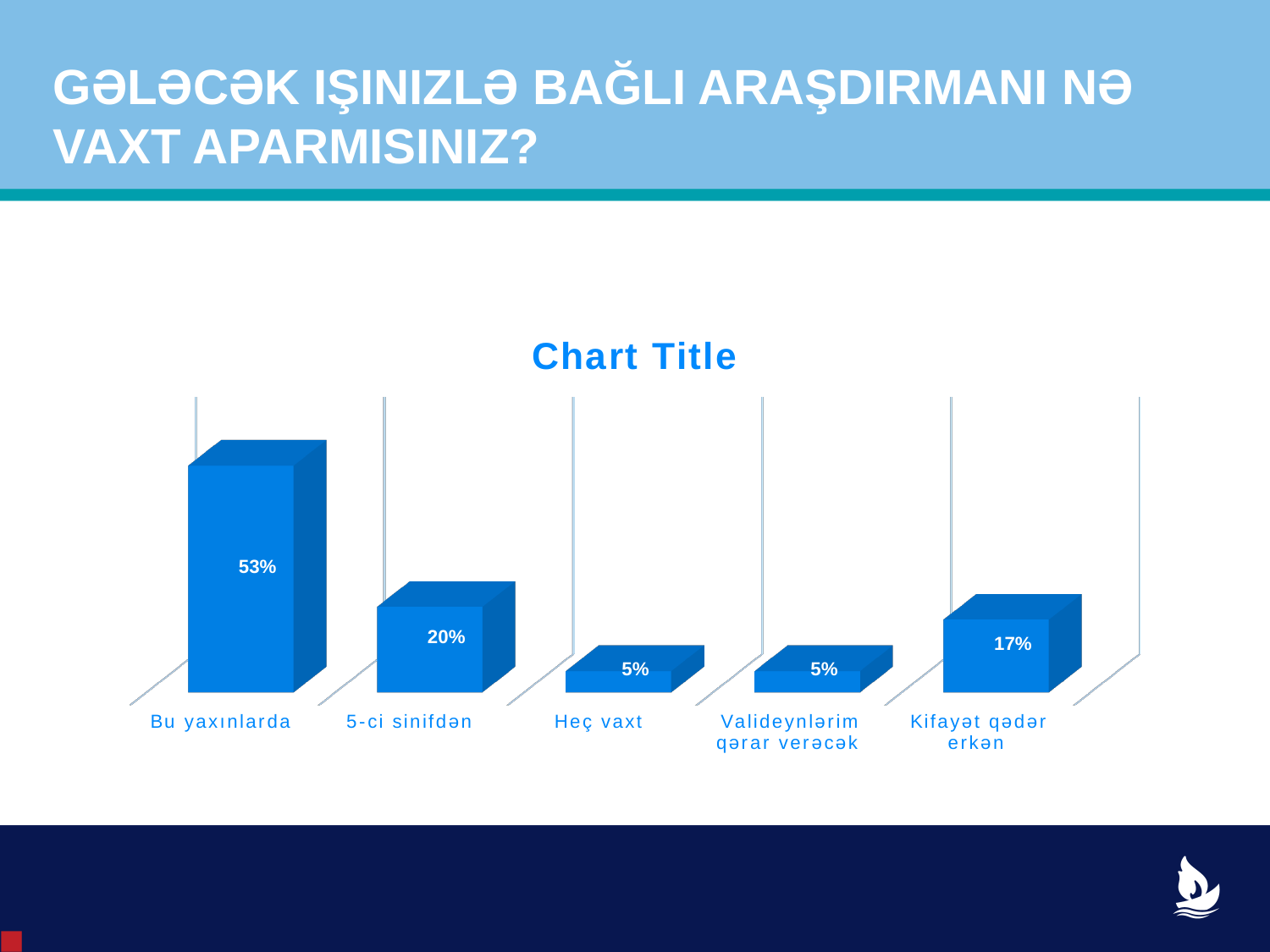
What is the value for "Bu yaxınlarda"? 53% Which is larger, the value for "5-ci sinifdən" or the value for "Kifayət qədər erkən"? 5-ci sinifdən How many categories are shown in the chart? 5 What is the title of the chart? Chart Title What is the value for "Heç vaxt"? 5% What is the value for "5-ci sinifdən"? 20% What is the value for "Kifayət qədər erkən"? 17% Which category has the highest value? Bu yaxınlarda What is the difference between the values for "Bu yaxınlarda" and "5-ci sinifdən"? 33% Which two categories share the same value of 5%? Heç vaxt and Valideynlərim qərar verəcək What kind of chart is shown on the slide? Bar chart What is the difference between the values for "5-ci sinifdən" and "Kifayət qədər erkən"? 3%